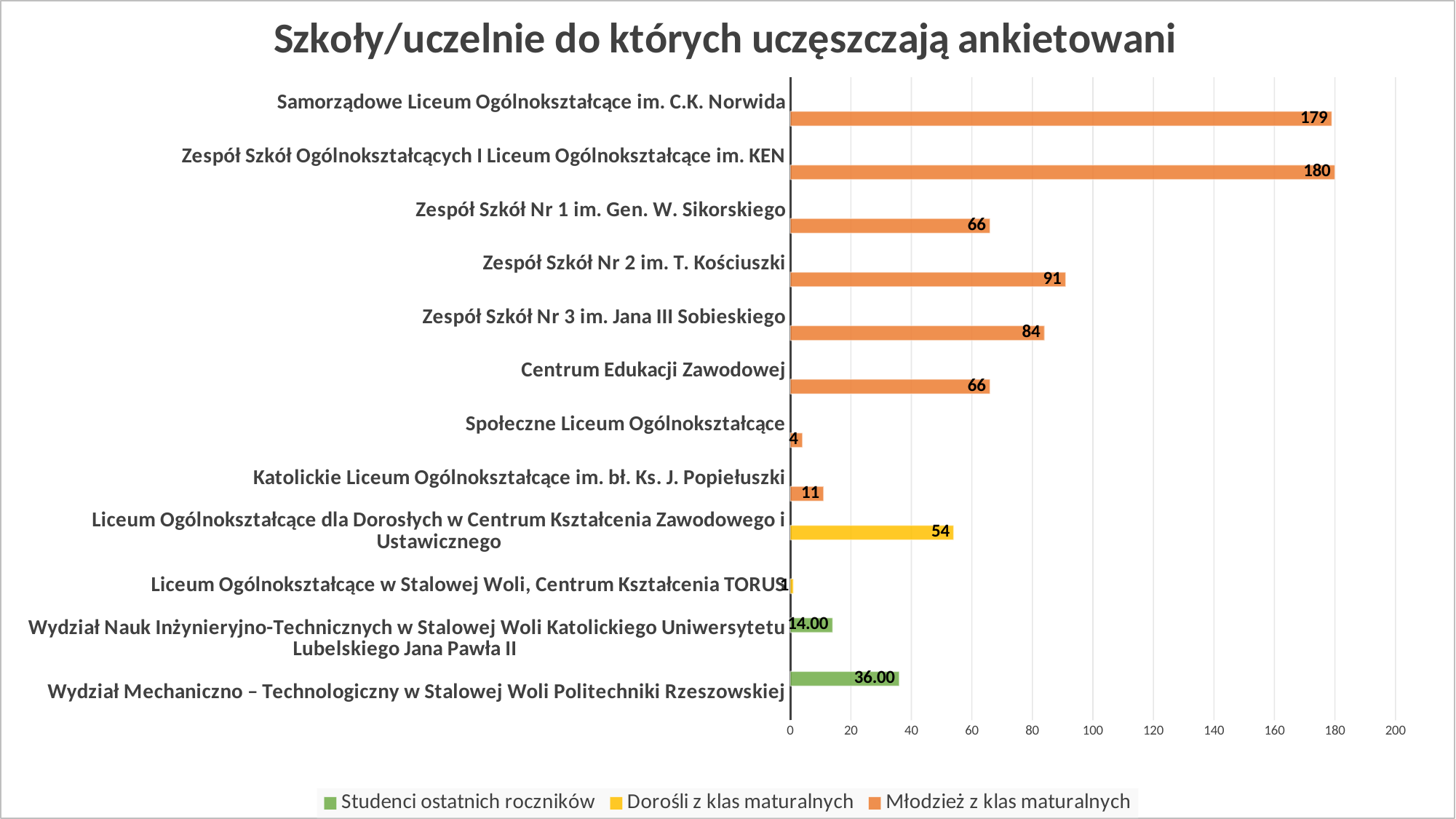
How many series does the legend list? 3 Which school has the highest value on the chart? Zespół Szkół Ogólnokształcących I Liceum Ogólnokształcące im. KEN What value is shown for Wydział Mechaniczno – Technologiczny w Stalowej Woli Politechniki Rzeszowskiej? 36.00 Which legend series is shown in green? Studenci ostatnich roczników How many schools/institutions are listed on the chart? 12 What is the difference between the values for Zespół Szkół Nr 2 im. T. Kościuszki and Zespół Szkół Nr 3 im. Jana III Sobieskiego? 7 Is the value for Centrum Edukacji Zawodowej greater or less than 80? less Which has a larger value: Samorządowe Liceum Ogólnokształcące im. C.K. Norwida or Zespół Szkół Nr 1 im. Gen. W. Sikorskiego? Samorządowe Liceum Ogólnokształcące im. C.K. Norwida What value is shown for Liceum Ogólnokształcące dla Dorosłych w Centrum Kształcenia Zawodowego i Ustawicznego? 54 Which school has the lowest value on the chart? Liceum Ogólnokształcące w Stalowej Woli, Centrum Kształcenia TORUS What kind of chart is shown on the slide? bar chart What value is shown for Zespół Szkół Nr 2 im. T. Kościuszki? 91